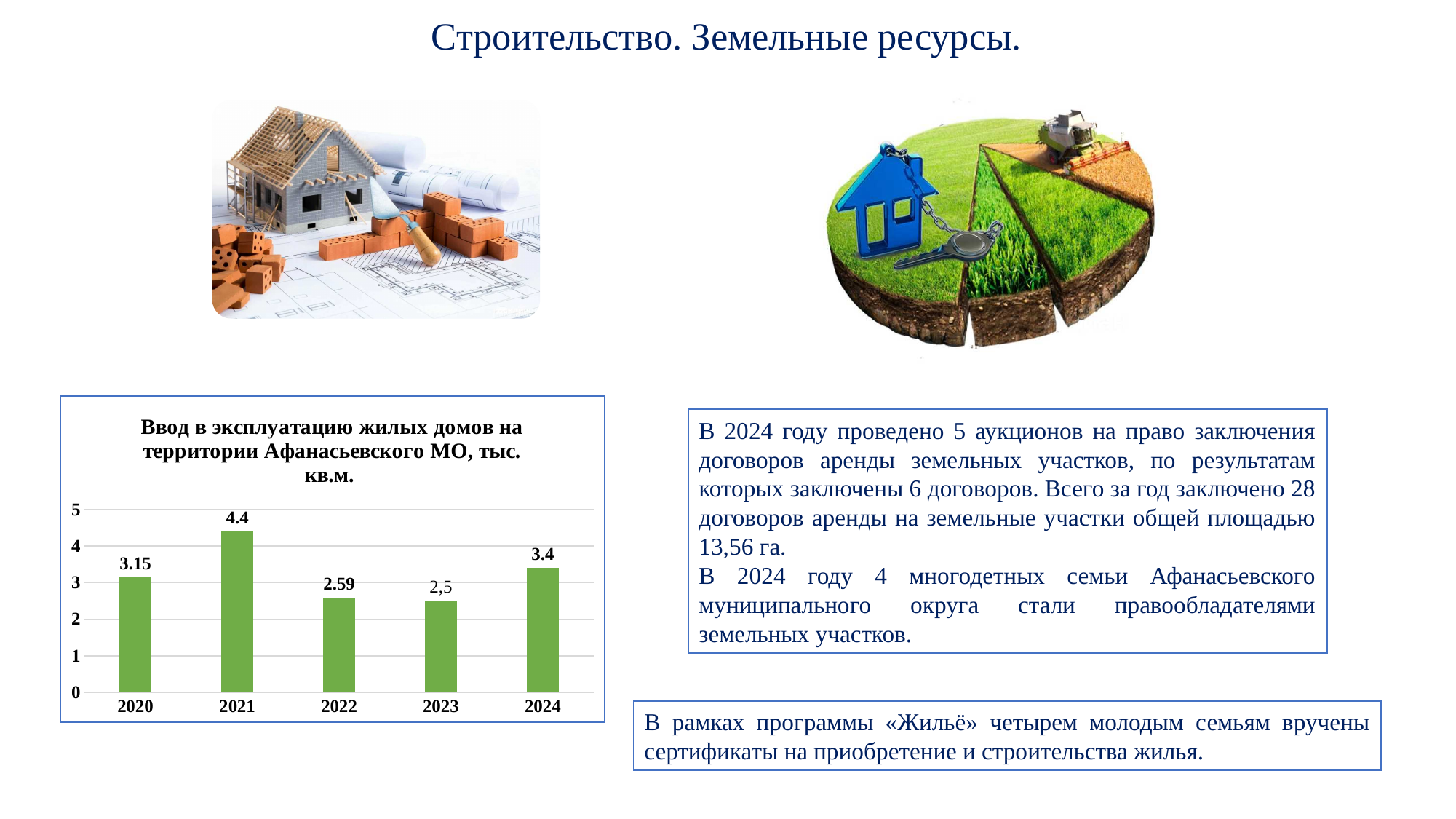
What is the title of the chart? Ввод в эксплуатацию жилых домов на территории Афанасьевского МО, тыс. кв.м. What is the value for 2023 in the chart? 2,5 What is the value for 2021 in the chart? 4.4 How many years are shown in the chart? 5 Is the value for 2021 greater or less than 4? greater What is the value for 2020 in the chart? 3.15 What is the difference between the values for 2021 and 2024? 1 What kind of chart is shown on the slide? bar chart Which is larger, the value for 2020 or the value for 2024? 2024 Which year has the lowest value in the chart? 2023 Which year has the highest value in the chart? 2021 What is the difference between the values for 2020 and 2022? 0.56